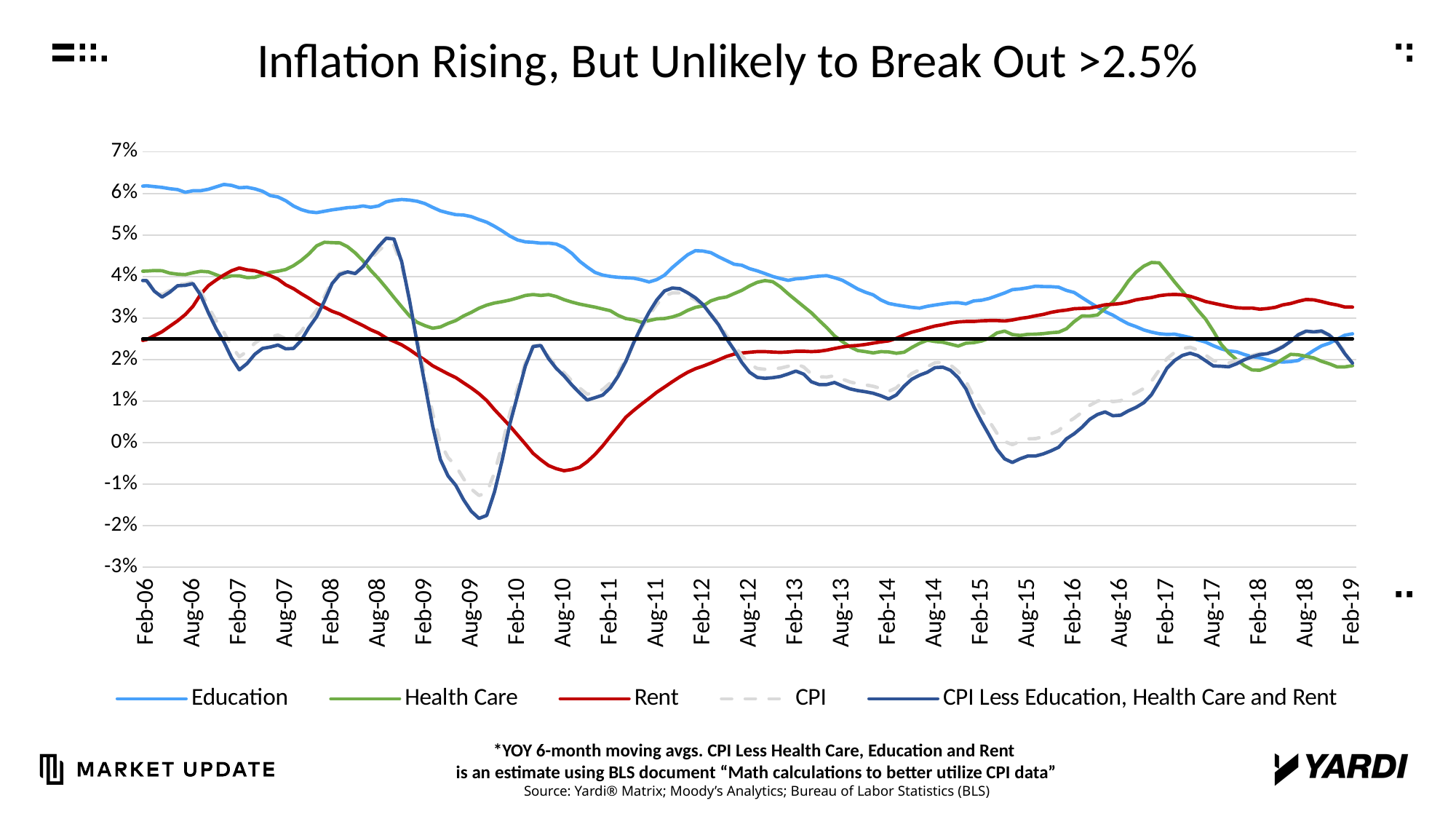
Is the value for Health Care in Feb-08 greater or less than 4%? greater Is the value for CPI Less Education, Health Care and Rent in Aug-09 greater or less than -1%? less What is the title of the chart? Inflation Rising, But Unlikely to Break Out >2.5% Is the value for Education in Feb-06 greater or less than 5%? greater What kind of chart is shown on the slide? Line chart Does the Education line generally rise or fall from Feb-06 to Feb-19? Fall In Feb-17, which is higher: Health Care or Rent? Health Care How many series does the legend list? 5 Which series has the highest value in Feb-06? Education Which series in the legend is drawn as a dashed line? CPI In Feb-06, which is higher: Education or Rent? Education